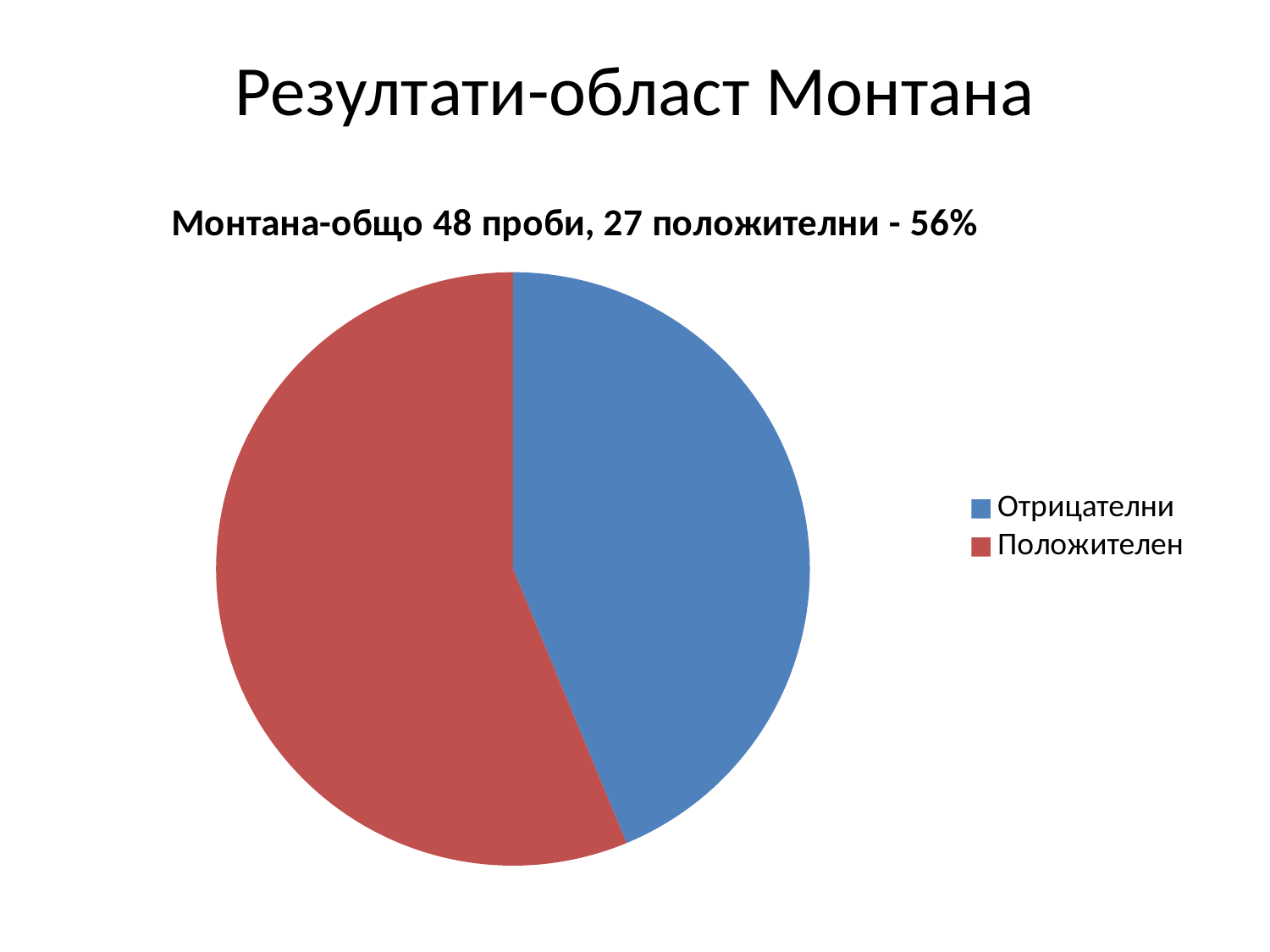
What kind of chart is shown on the slide? pie chart Is the share of the Положителен slice greater or less than 50%? greater Which slice of the pie chart is the largest? Положителен According to the chart title, how many samples were positive? 27 Which slice of the pie chart is the smallest? Отрицателни Which slice is larger, Положителен or Отрицателни? Положителен What is the title of the pie chart? Монтана-общо 48 проби, 27 положителни - 56% How many entries does the legend of the pie chart list? 2 How many slices does the pie chart have? 2 What share of the pie does the Положителен slice represent, as stated in the chart title? 56% According to the chart title, how many samples in total were tested in Montana? 48 What colour is the Отрицателни slice in the pie chart? blue